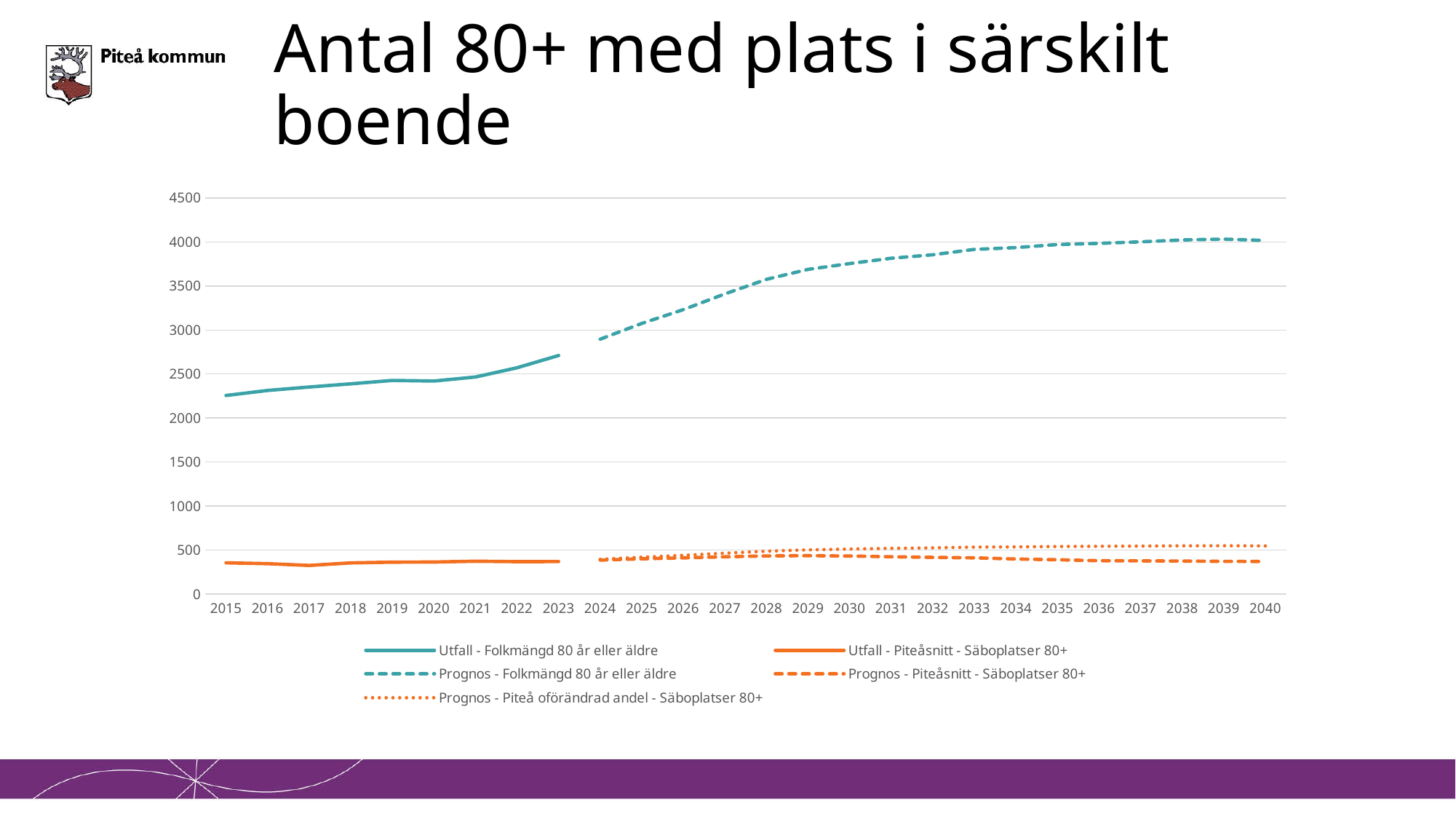
Does the 'Utfall - Folkmängd 80 år eller äldre' line rise or fall from 2015 to 2023? rise Which legend entry is drawn with a dotted orange line? Prognos - Piteå oförändrad andel - Säboplatser 80+ What kind of chart is shown on the slide? line chart Is the value for 'Prognos - Folkmängd 80 år eller äldre' in 2024 greater or less than 3000? less In 2040, which is larger: 'Prognos - Piteå oförändrad andel - Säboplatser 80+' or 'Prognos - Piteåsnitt - Säboplatser 80+'? Prognos - Piteå oförändrad andel - Säboplatser 80+ How many years are shown on the x axis? 26 Is the value for 'Utfall - Piteåsnitt - Säboplatser 80+' in 2015 greater or less than 500? less How many series does the legend list? 5 What is the title of the slide containing the chart? Antal 80+ med plats i särskilt boende Is the value for 'Utfall - Folkmängd 80 år eller äldre' in 2015 greater or less than 2000? greater Does the 'Prognos - Folkmängd 80 år eller äldre' line rise or fall from 2024 to 2040? rise